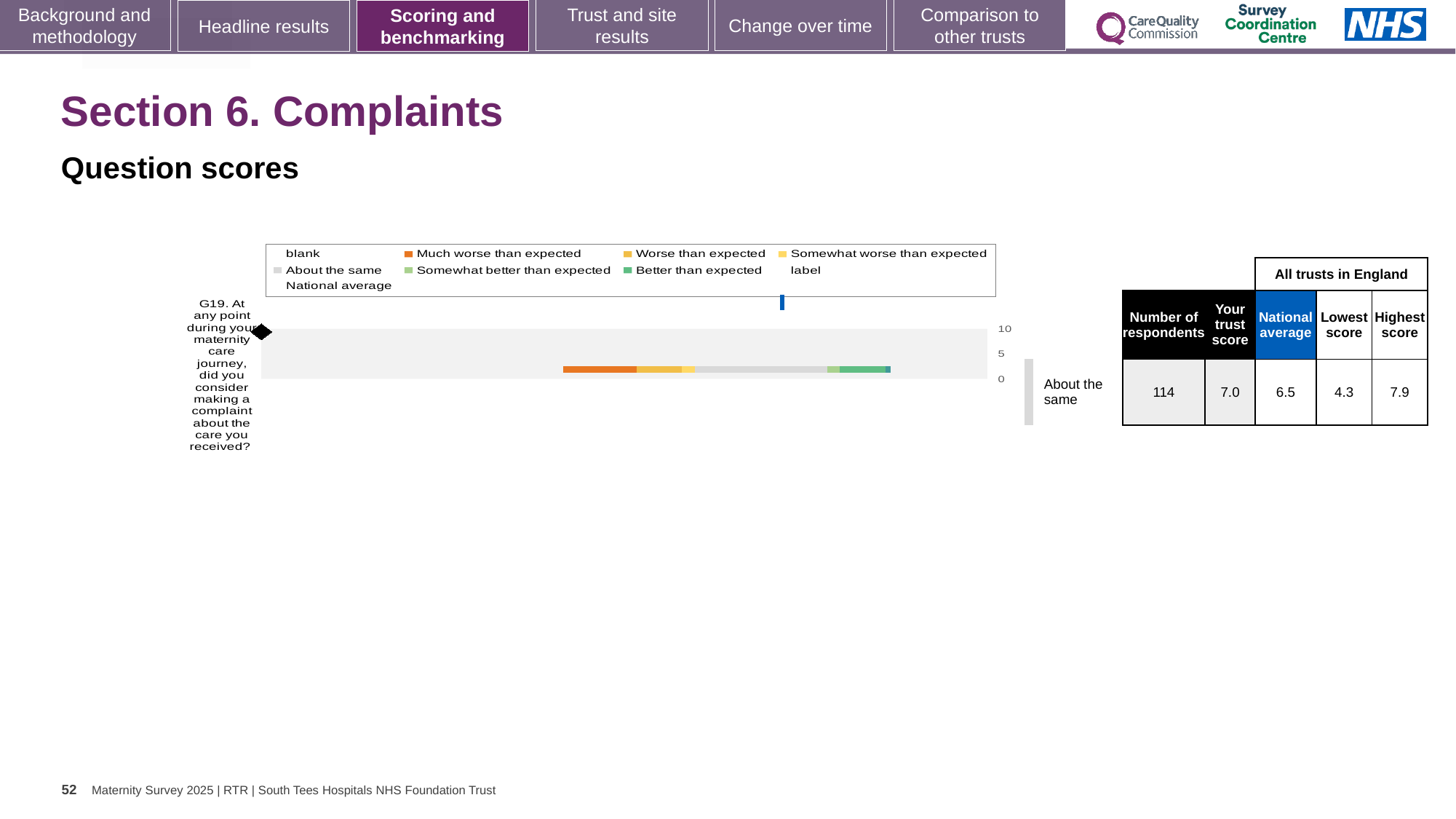
Which question number is plotted in the chart? G19 What is the difference between the trust's score and the national average for question G19? 0.5 How many survey questions are plotted in the chart? 1 According to the table beside the chart, what is the national average for question G19? 6.5 What is the difference between the highest and lowest scores among all trusts in England for question G19? 3.6 According to the table beside the chart, how many respondents answered question G19? 114 Is the trust's score for question G19 larger or smaller than the national average? larger What kind of chart is shown on the slide? bar chart According to the table beside the chart, what is the lowest score among all trusts in England for question G19? 4.3 According to the table beside the chart, what is the highest score among all trusts in England for question G19? 7.9 According to the table beside the chart, what is the trust's score for question G19? 7.0 What benchmark category is shown next to the chart for question G19? About the same